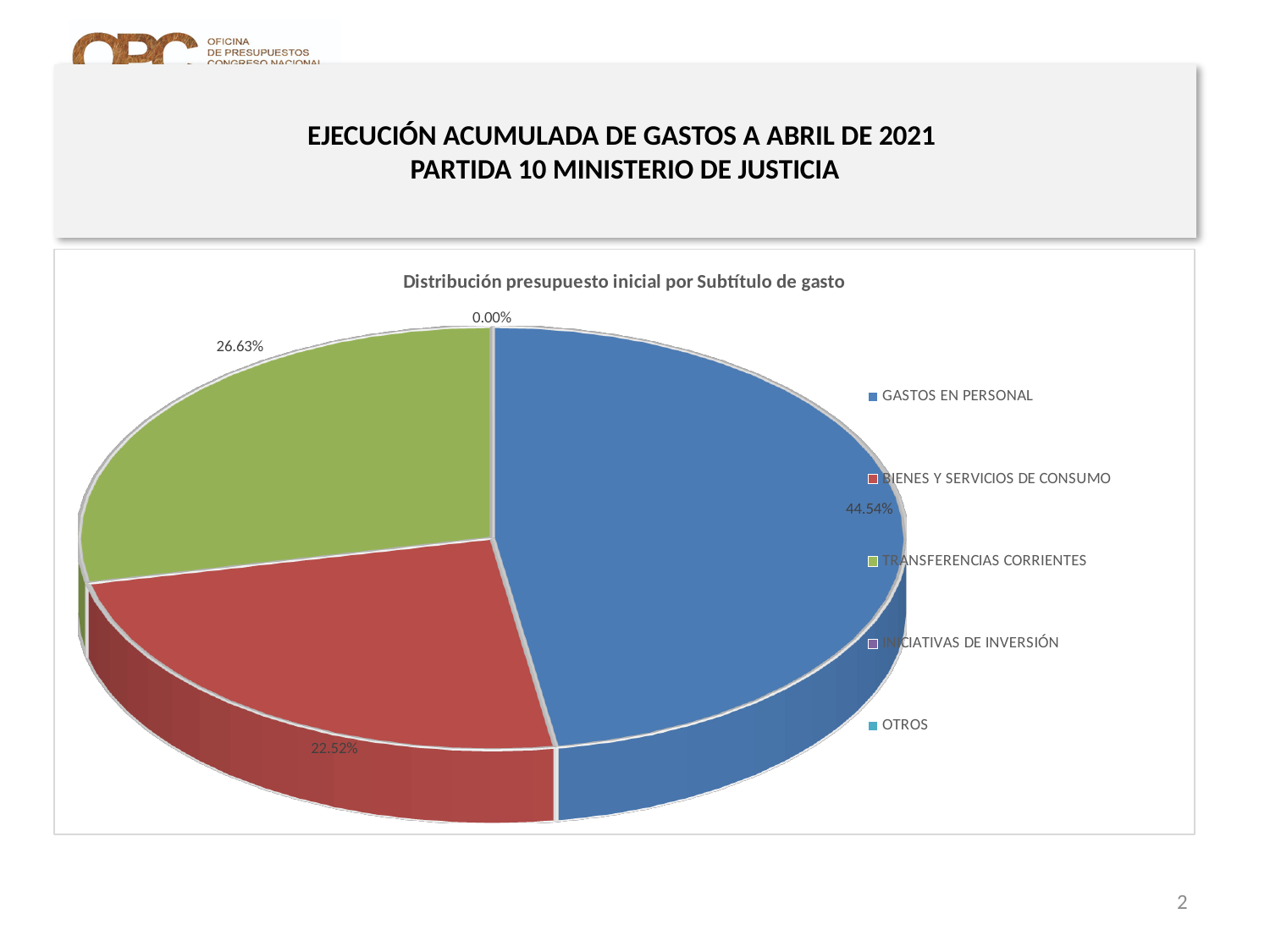
What is the title of the chart? Distribución presupuesto inicial por Subtítulo de gasto Which category has the largest slice of the pie? GASTOS EN PERSONAL What is the difference in percentage points between TRANSFERENCIAS CORRIENTES and BIENES Y SERVICIOS DE CONSUMO? 4.11 Which is larger, the slice for GASTOS EN PERSONAL or the slice for TRANSFERENCIAS CORRIENTES? GASTOS EN PERSONAL What is the difference in percentage points between GASTOS EN PERSONAL and BIENES Y SERVICIOS DE CONSUMO? 22.02 What type of chart is shown on the slide? Pie chart What colour is the slice for GASTOS EN PERSONAL? Blue How many entries does the chart legend list? 5 What share of the pie does TRANSFERENCIAS CORRIENTES represent? 26.63% What share of the pie does BIENES Y SERVICIOS DE CONSUMO represent? 22.52% Which is larger, the slice for TRANSFERENCIAS CORRIENTES or the slice for BIENES Y SERVICIOS DE CONSUMO? TRANSFERENCIAS CORRIENTES What share of the pie does GASTOS EN PERSONAL represent? 44.54%